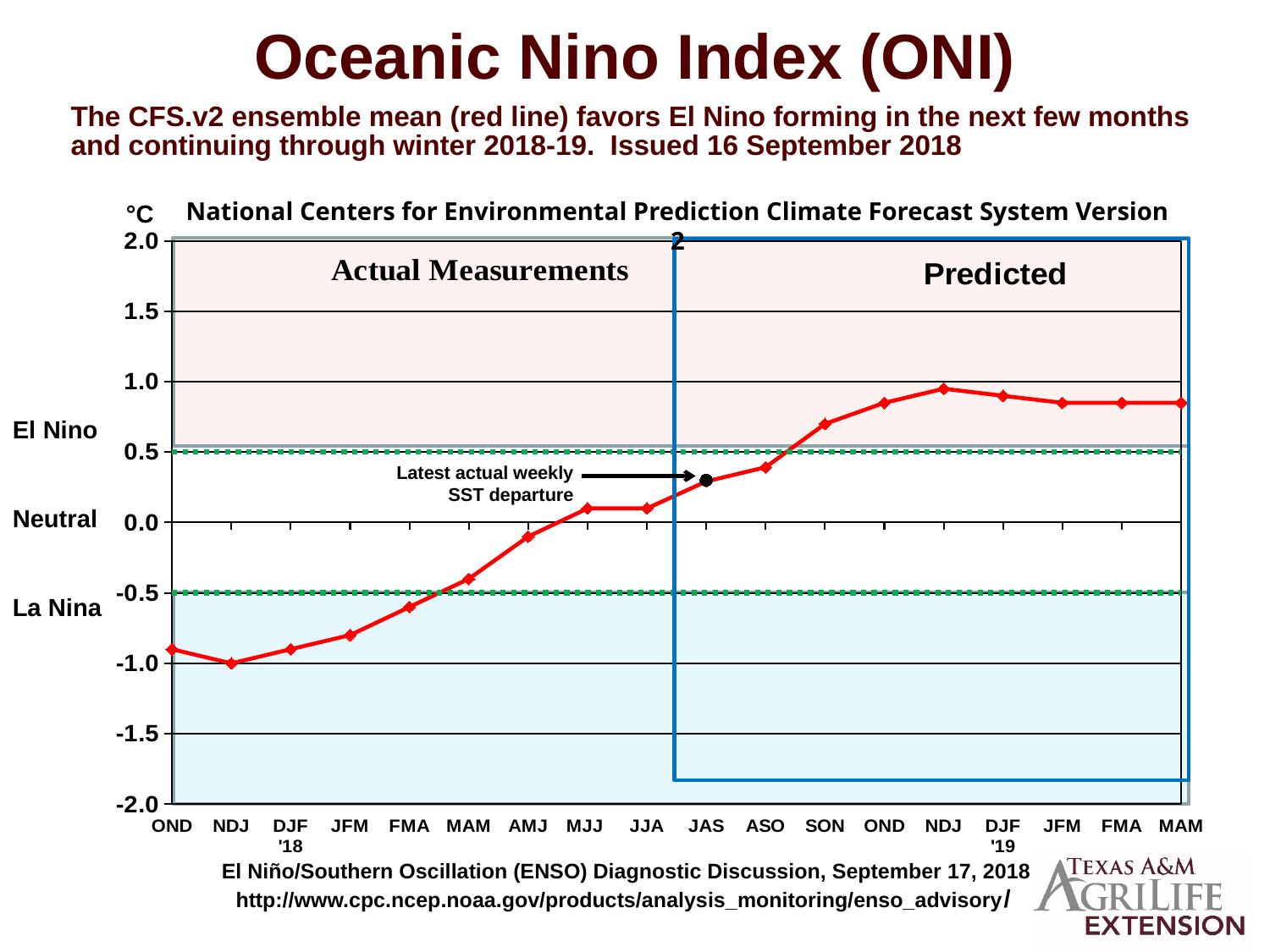
What kind of chart is shown on the slide? line chart Which has the larger ONI value, JAS or SON? SON What unit is shown on the y axis? °C Is the value for SON greater or less than 0.5? greater Does the red line generally rise or fall from NDJ '18 to the second NDJ? rise Is the value for MAM '19 (the last period) greater or less than 0.5? greater What label is given to the right-hand section of the chart enclosed by the blue box? Predicted Which x-axis period has the highest ONI value on the red line? NDJ (the second NDJ, in the Predicted section) Is the value for AMJ greater or less than 0.0? less Which x-axis period has the lowest ONI value on the red line? NDJ (the first NDJ, in the Actual Measurements section) How many three-month periods are labelled along the x axis? 18